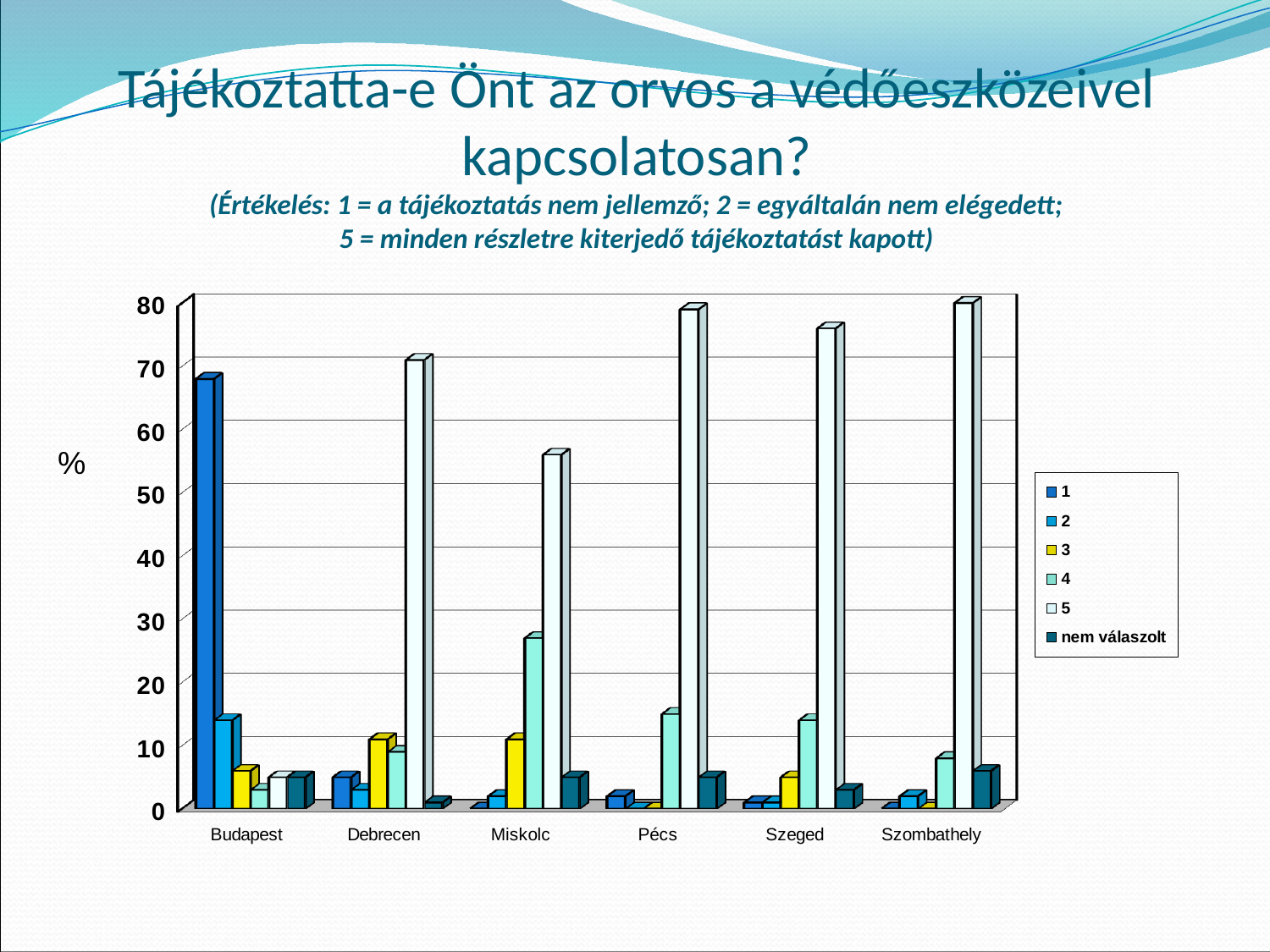
How many series does the legend list? 6 Which series has the highest bar for Budapest? 1 Which city has the highest bar for series 1? Budapest Is the value for series 1 in Budapest greater or less than 60? greater Is the value for series 4 in Miskolc greater or less than 20? greater Which is larger: the series 4 bar for Miskolc or the series 4 bar for Pécs? Miskolc Which city has the lowest bar for series 5? Budapest How many cities are shown on the x axis of the chart? 6 Is the value for series 5 in Miskolc greater or less than 50? greater What kind of chart is shown on the slide? bar chart Which series has the highest bar for Miskolc? 5 What is the label of the last entry in the legend? nem válaszolt